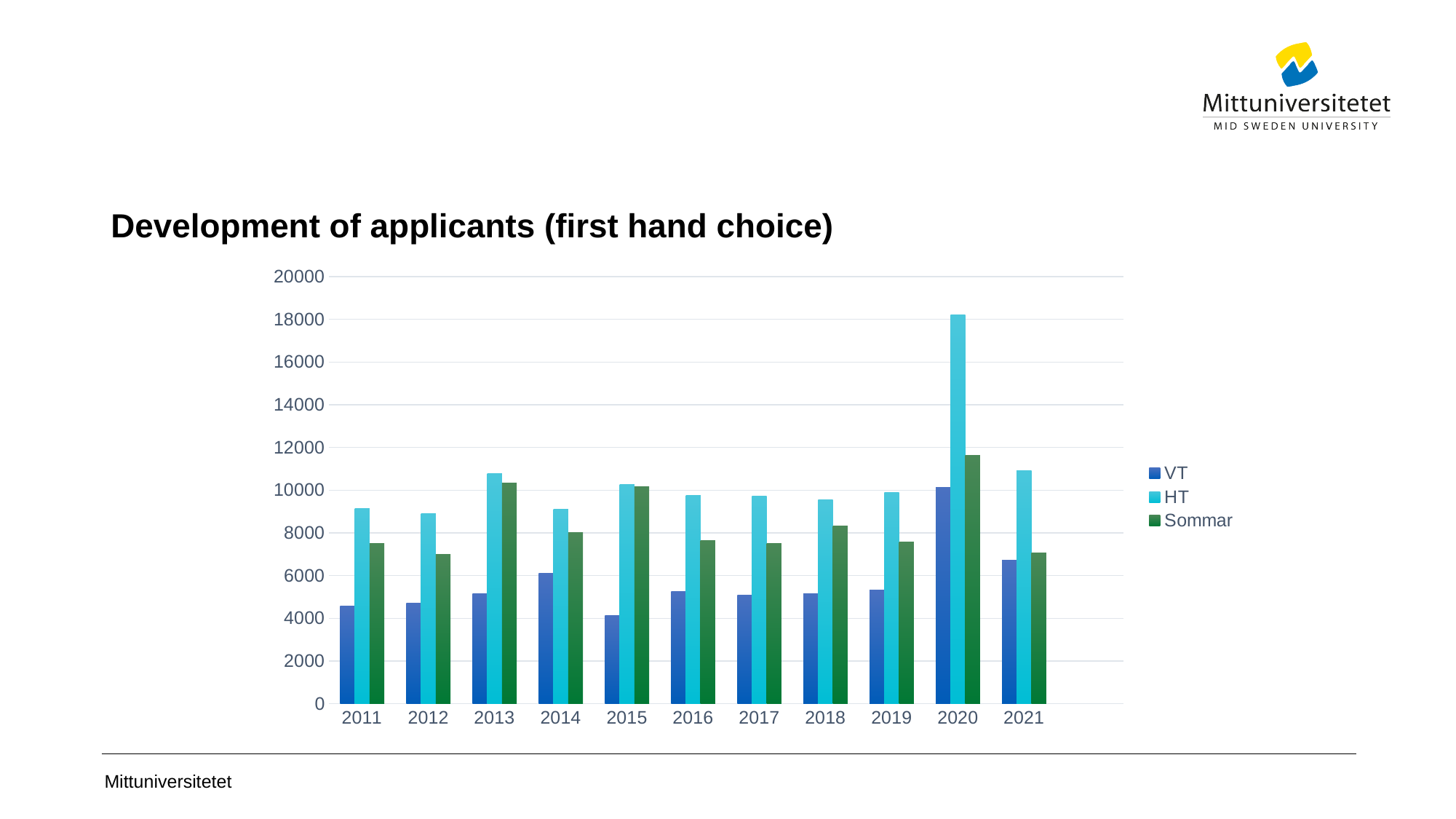
In which year is the VT value highest? 2020 In which year is the HT value highest? 2020 What kind of chart is shown on the slide? Bar chart In which year is the Sommar value highest? 2020 What are the three series listed in the legend? VT, HT, Sommar Is the Sommar value for 2020 greater or less than 10000? greater Is the VT value for 2015 greater or less than 6000? less In which year is the VT value lowest? 2015 Is the HT value for 2020 greater or less than 16000? greater Which is larger in 2021, the HT value or the Sommar value? HT How many series does the legend list? 3 How many years are shown on the x axis? 11